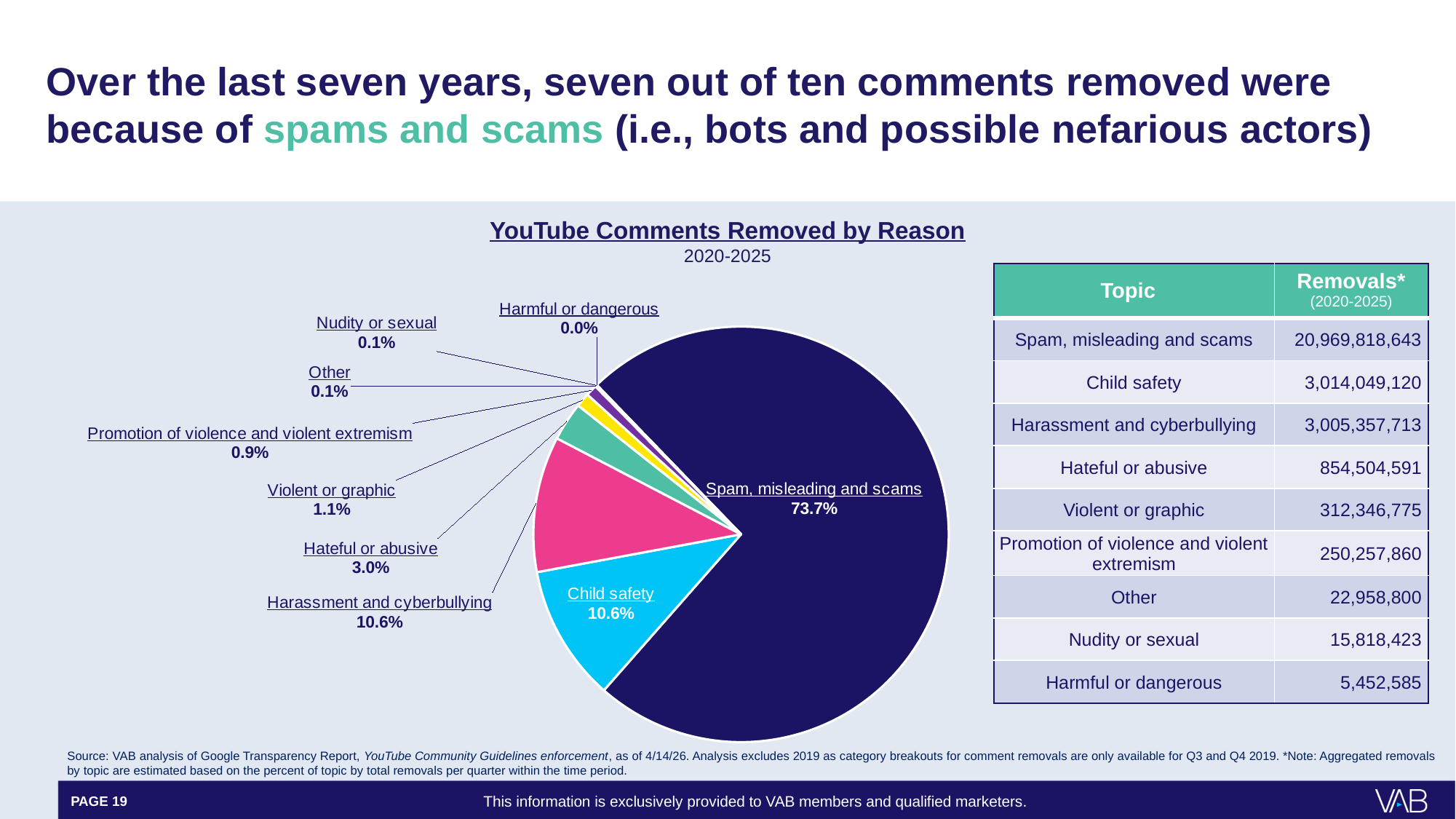
What colour is the Child safety slice in the pie chart? Light blue What share of the pie does Spam, misleading and scams account for? 73.7% Which category has the largest slice of the pie? Spam, misleading and scams What kind of chart is shown on the slide? Pie chart What is the value shown for Promotion of violence and violent extremism in the pie chart? 0.9% What is the value shown for Hateful or abusive in the pie chart? 3.0% Which category has the smallest slice of the pie? Harmful or dangerous Which is larger in the pie chart, Hateful or abusive or Violent or graphic? Hateful or abusive How many categories are shown in the pie chart? 9 What is the value shown for Child safety in the pie chart? 10.6% What is the difference in percentage points between Spam, misleading and scams and Child safety? 63.1% What is the title of the chart? YouTube Comments Removed by Reason